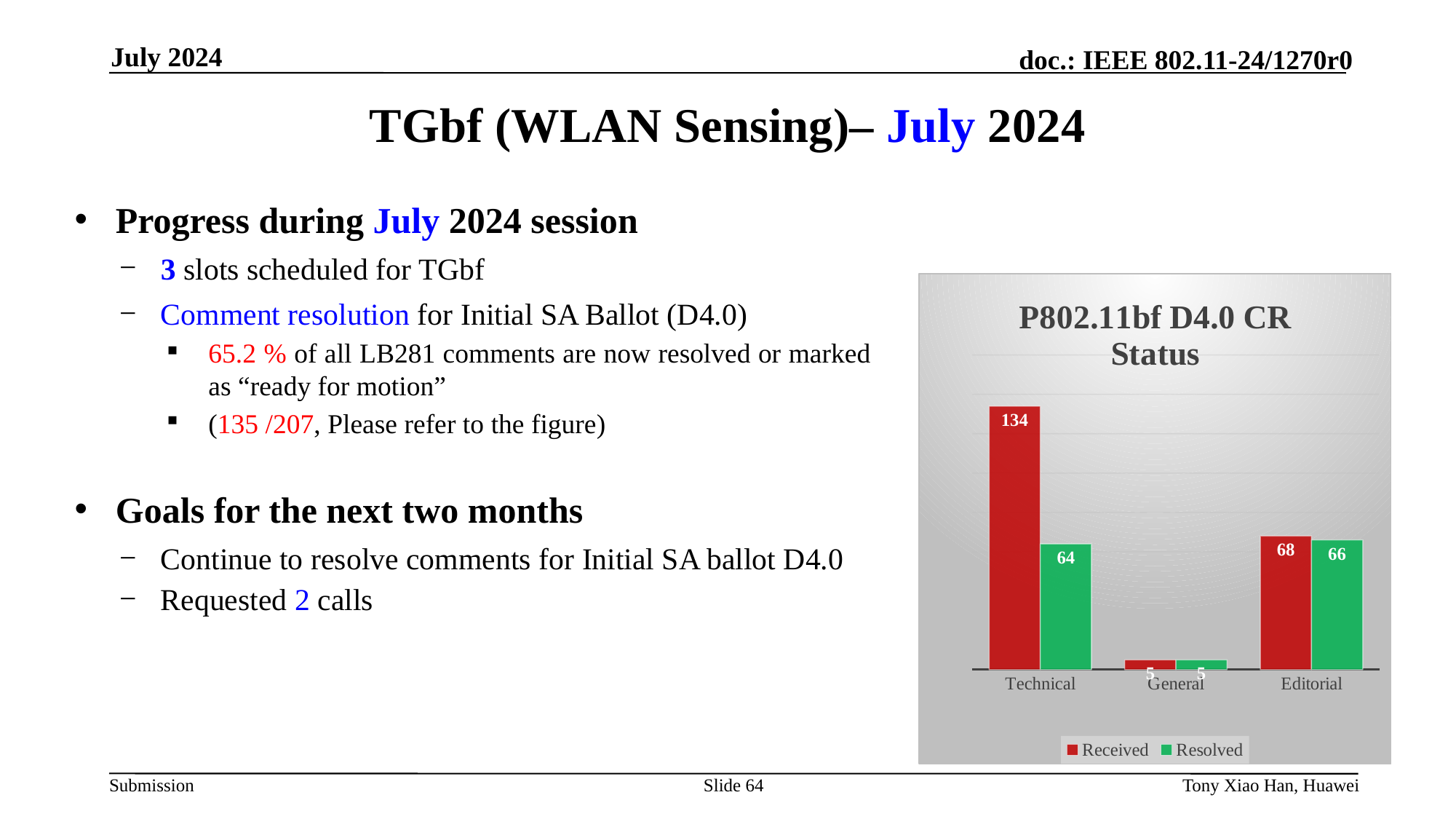
Which category has the highest Received value? Technical What is the Received value for Technical? 134 How many categories are shown on the x axis? 3 What is the title of the chart? P802.11bf D4.0 CR Status What kind of chart is shown? Bar chart What is the Resolved value for Technical? 64 Which is larger for Editorial, Received or Resolved? Received What is the difference between Received and Resolved for Technical? 70 What is the Received value for Editorial? 68 How many series does the legend list? 2 Which category has the lowest Resolved value? General What is the Resolved value for General? 5